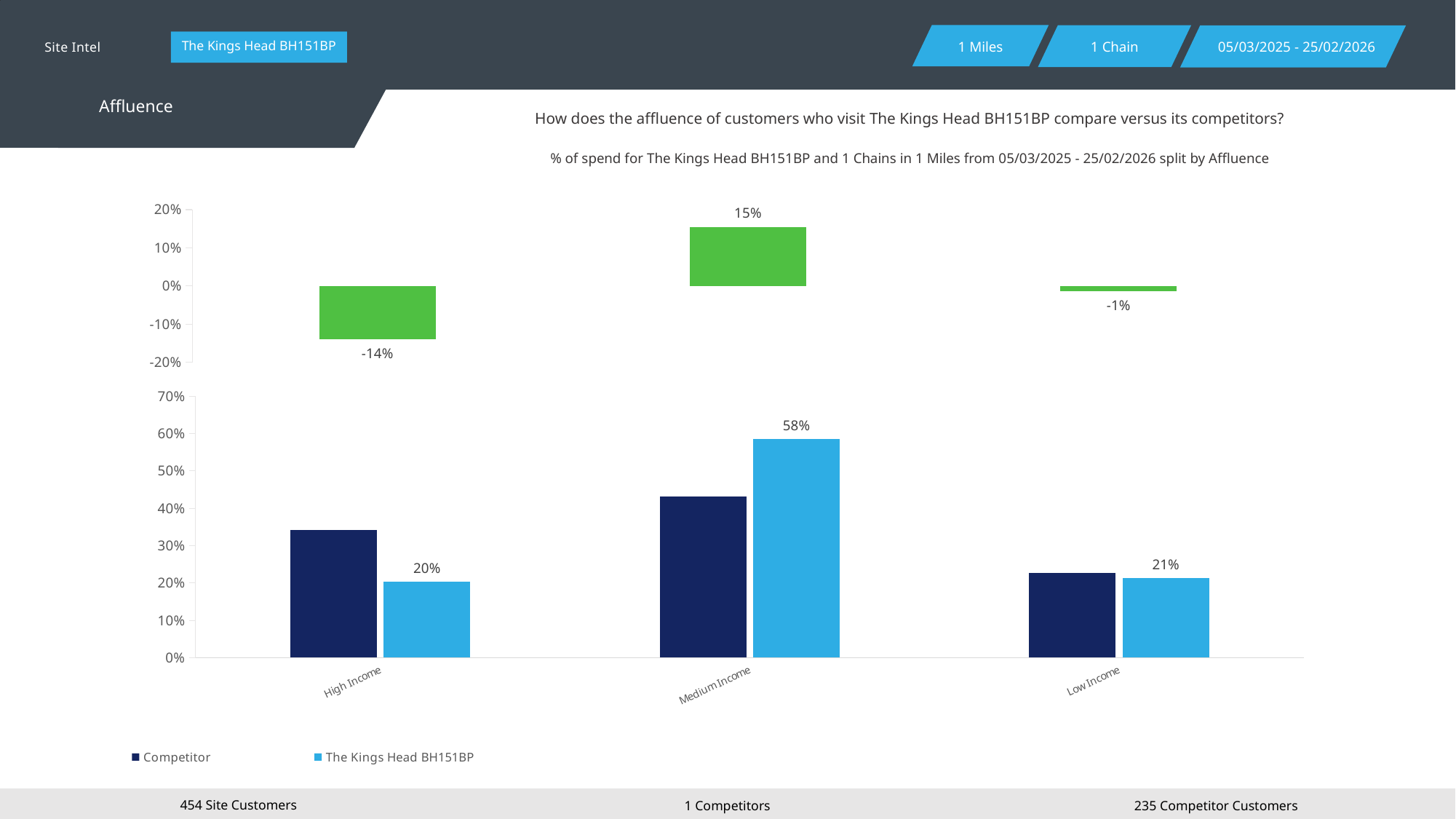
In the bottom chart, is the Competitor value for Medium Income greater or less than 50%? less In the bottom chart, which category has the highest value for The Kings Head BH151BP? Medium Income What type of chart is the bottom chart? Bar chart How many series does the legend of the bottom chart list? 2 In the bottom chart, what is the value for The Kings Head BH151BP in the Medium Income category? 58% In the bottom chart, what is the value for The Kings Head BH151BP in the High Income category? 20% In the bottom chart, which is larger for High Income: the Competitor bar or The Kings Head BH151BP bar? Competitor In the bottom chart, what is the difference between The Kings Head BH151BP values for Medium Income and Low Income? 37% In the top chart, what is the value shown for High Income? -14% In the bottom chart, is the Competitor value for High Income greater or less than 30%? greater In the top chart, what is the value shown for Medium Income? 15% In the top chart, which category has the lowest value? High Income